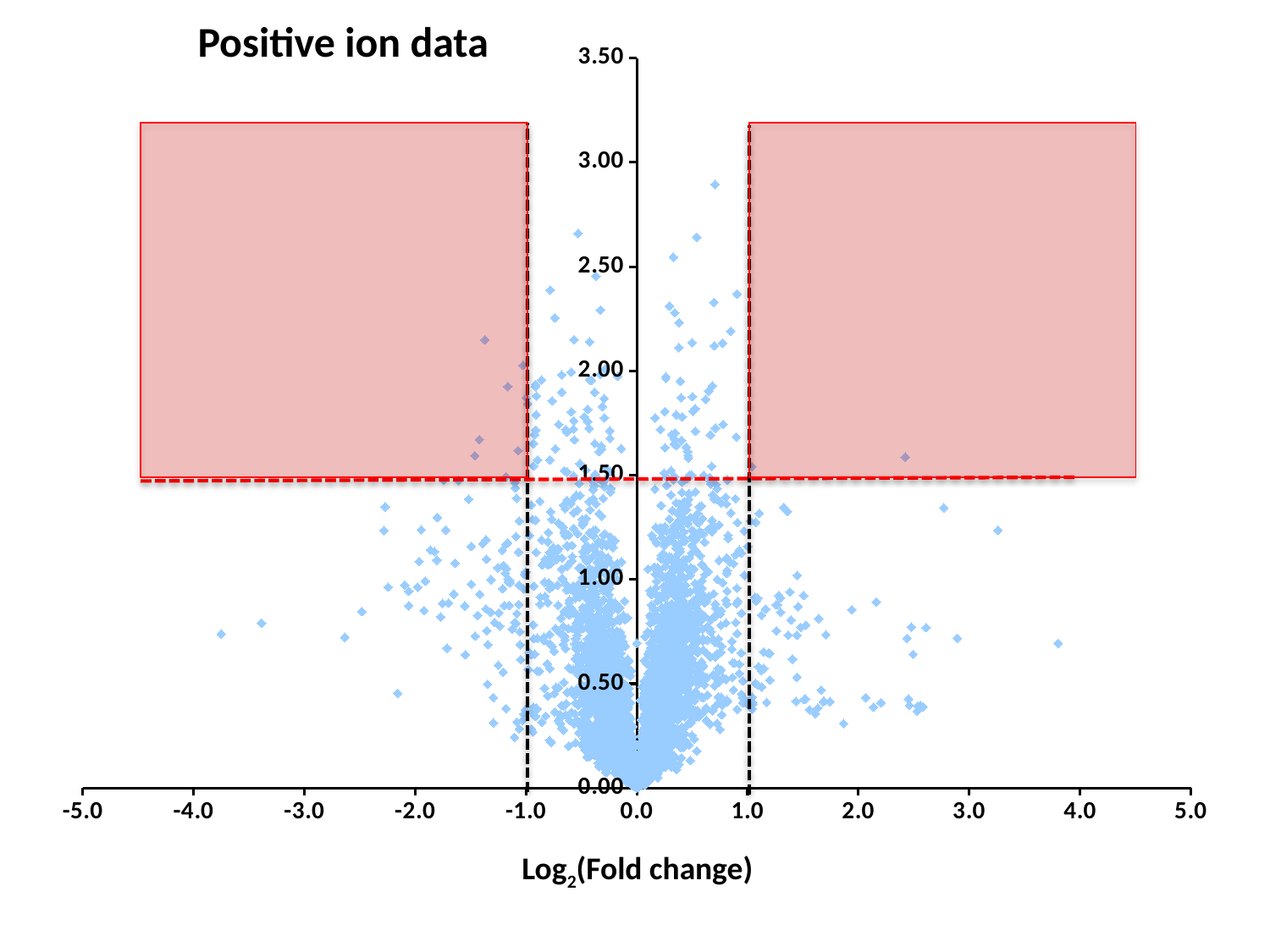
Is the x value of the leftmost plotted point greater or less than -4.0? greater Is the y value of the highest plotted point greater or less than 2.50? greater What is the label of the x axis? Log2(Fold change) Is the x value of the leftmost plotted point greater or less than -3.0? less What kind of chart is shown on the slide? scatter chart What is the title of the chart? Positive ion data